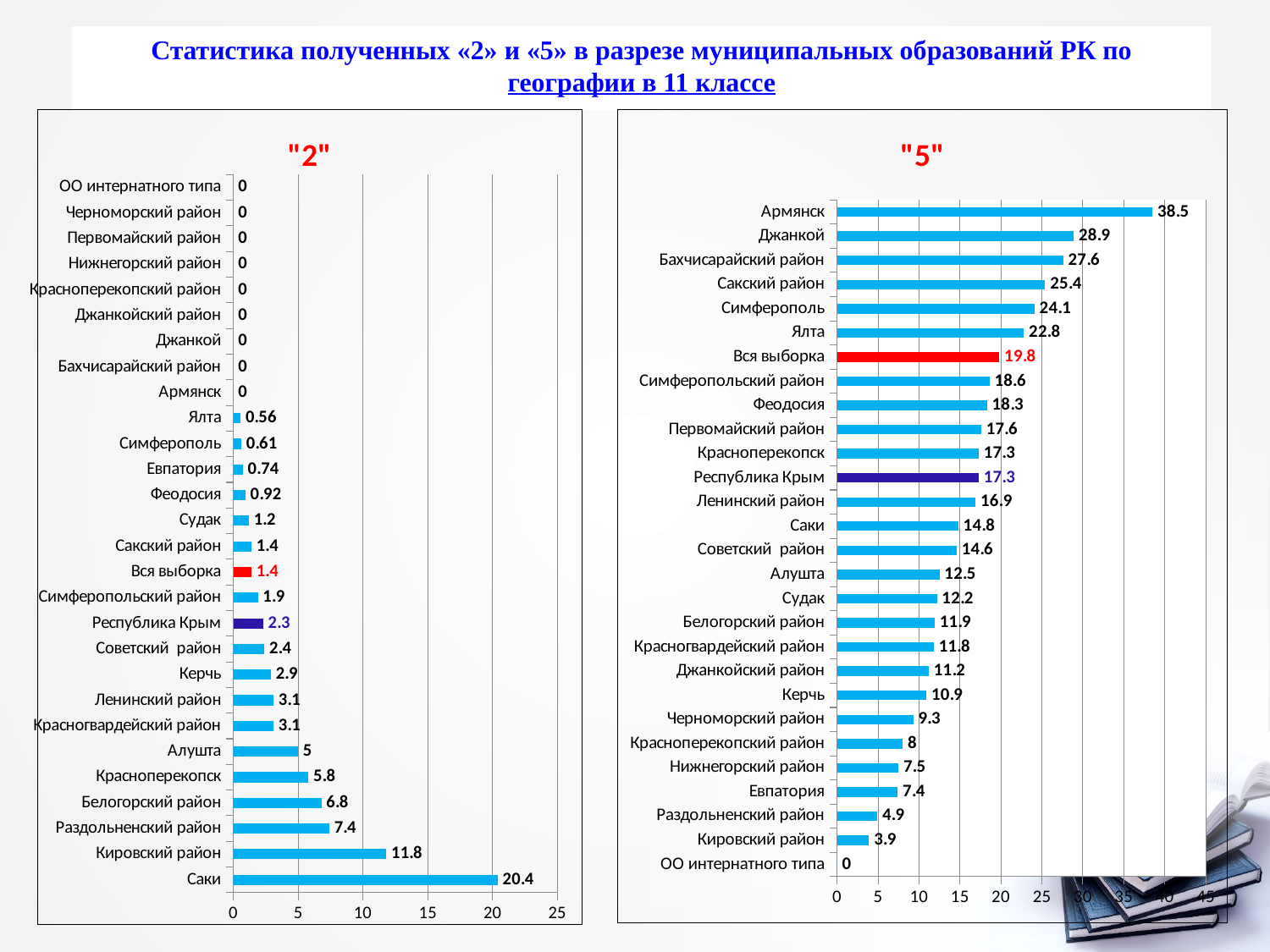
In the "5" chart, which category has the lowest value? ОО интернатного типа How many categories are shown in the "5" chart? 28 In the "2" chart, which category has the highest value? Саки In the "2" chart, what is the value for Республика Крым? 2.3 In the "5" chart, which is larger: Ялта or Симферополь? Симферополь In the "5" chart, what is the value for Армянск? 38.5 In the "5" chart, what is the difference between Джанкой and Бахчисарайский район? 1.3 In the "2" chart, what is the difference between Кировский район and Раздольненский район? 4.4 What type of chart is the "2" chart? Bar chart In the "2" chart, what is the value for Саки? 20.4 In the "2" chart, which is larger: Алушта or Красноперекопск? Красноперекопск In the "5" chart, what is the value for Вся выборка? 19.8